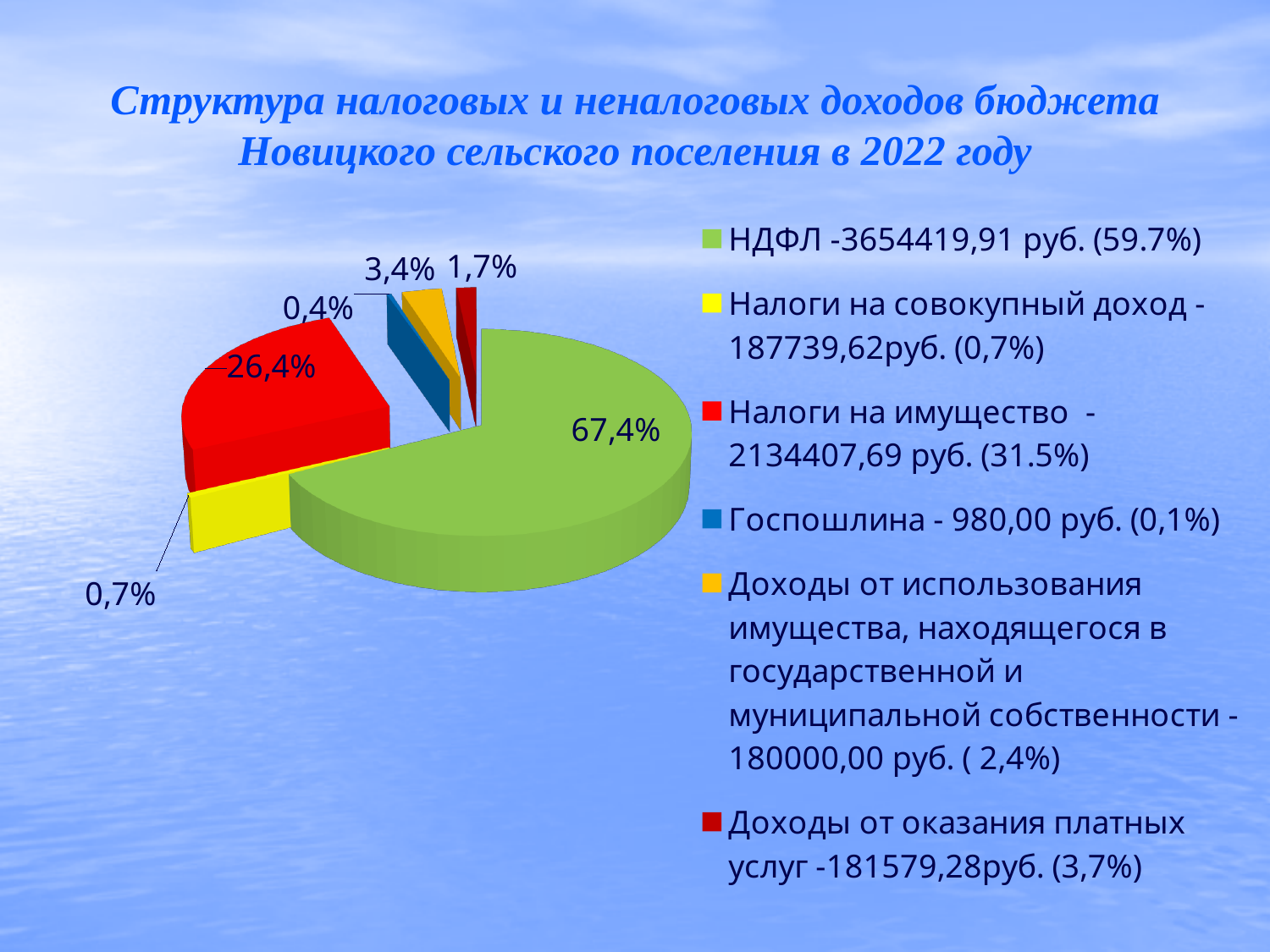
How many slices does the pie chart have? 6 What data label is shown on the green НДФЛ slice of the pie chart? 67,4% What data label is shown on the red Налоги на имущество slice of the pie chart? 26,4% What data label is shown on the blue Госпошлина slice of the pie chart? 0,4% What type of chart is shown on the slide? pie chart Which slice of the pie chart has the largest data label? НДФЛ What data label is shown on the orange slice for Доходы от использования имущества in the pie chart? 3,4% What ruble amount does the legend give for Госпошлина? 980,00 руб. Which slice of the pie chart has the smallest data label? Госпошлина According to the data labels on the pie chart, which slice is larger: Налоги на имущество or Доходы от оказания платных услуг? Налоги на имущество What data label is shown on the yellow Налоги на совокупный доход slice of the pie chart? 0,7% How many entries does the legend of the pie chart list? 6